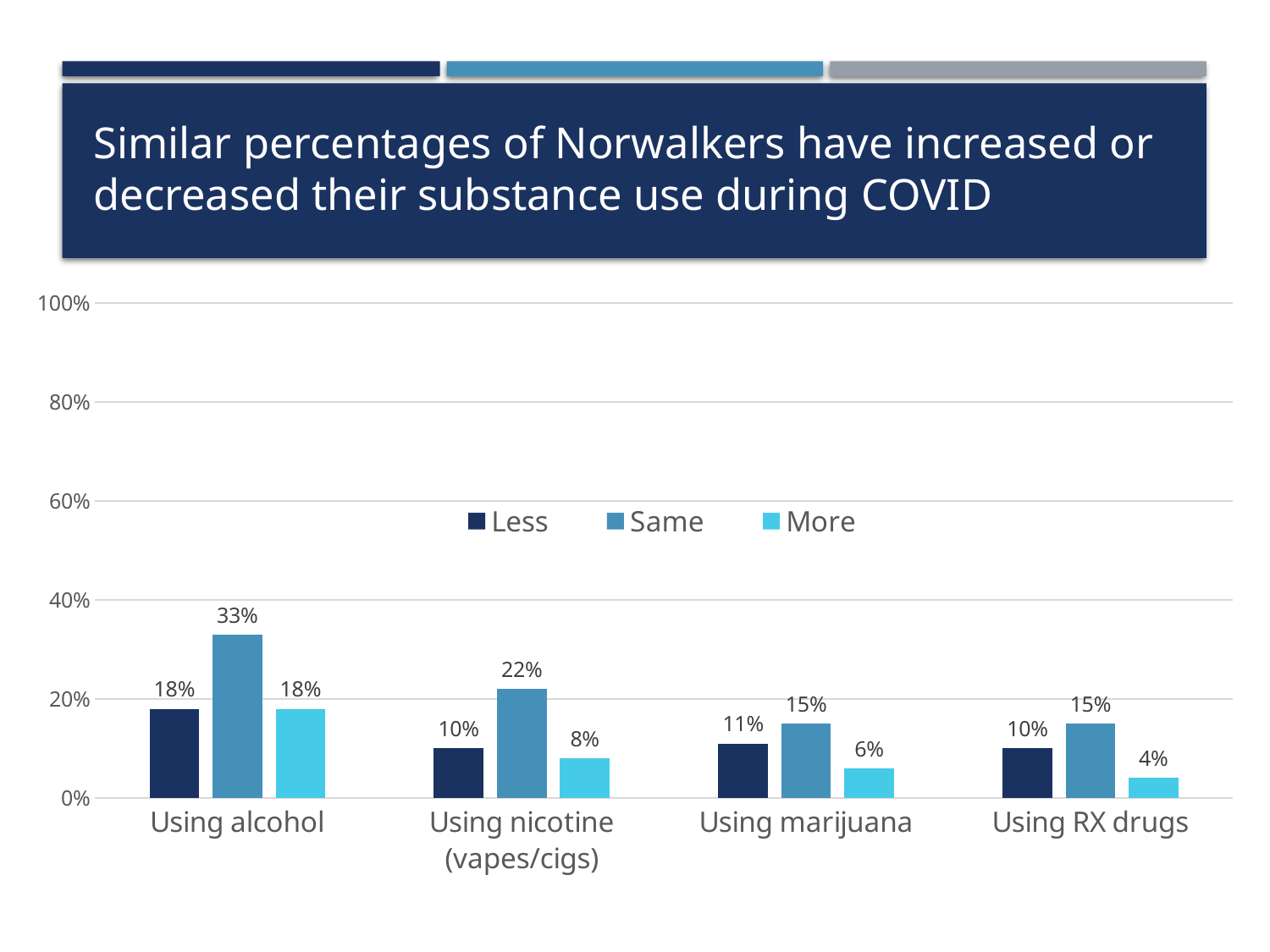
How many series does the legend list? 3 What is the value for 'Less' in the 'Using marijuana' category? 11% What is the value for 'More' in the 'Using RX drugs' category? 4% What is the difference between the 'Same' and 'Less' values for 'Using nicotine (vapes/cigs)'? 12% Is the 'Same' value for 'Using alcohol' greater or less than 40%? less Which is larger: the 'More' value for 'Using alcohol' or the 'More' value for 'Using nicotine (vapes/cigs)'? Using alcohol Which category has the lowest 'More' value? Using RX drugs Does the 'More' series rise or fall across the categories from left to right? Fall What percentage of Norwalkers reported using alcohol the same amount during COVID? 33% How many categories are shown on the x axis? 4 What kind of chart is shown on the slide? Bar chart Which category has the highest 'Same' value? Using alcohol